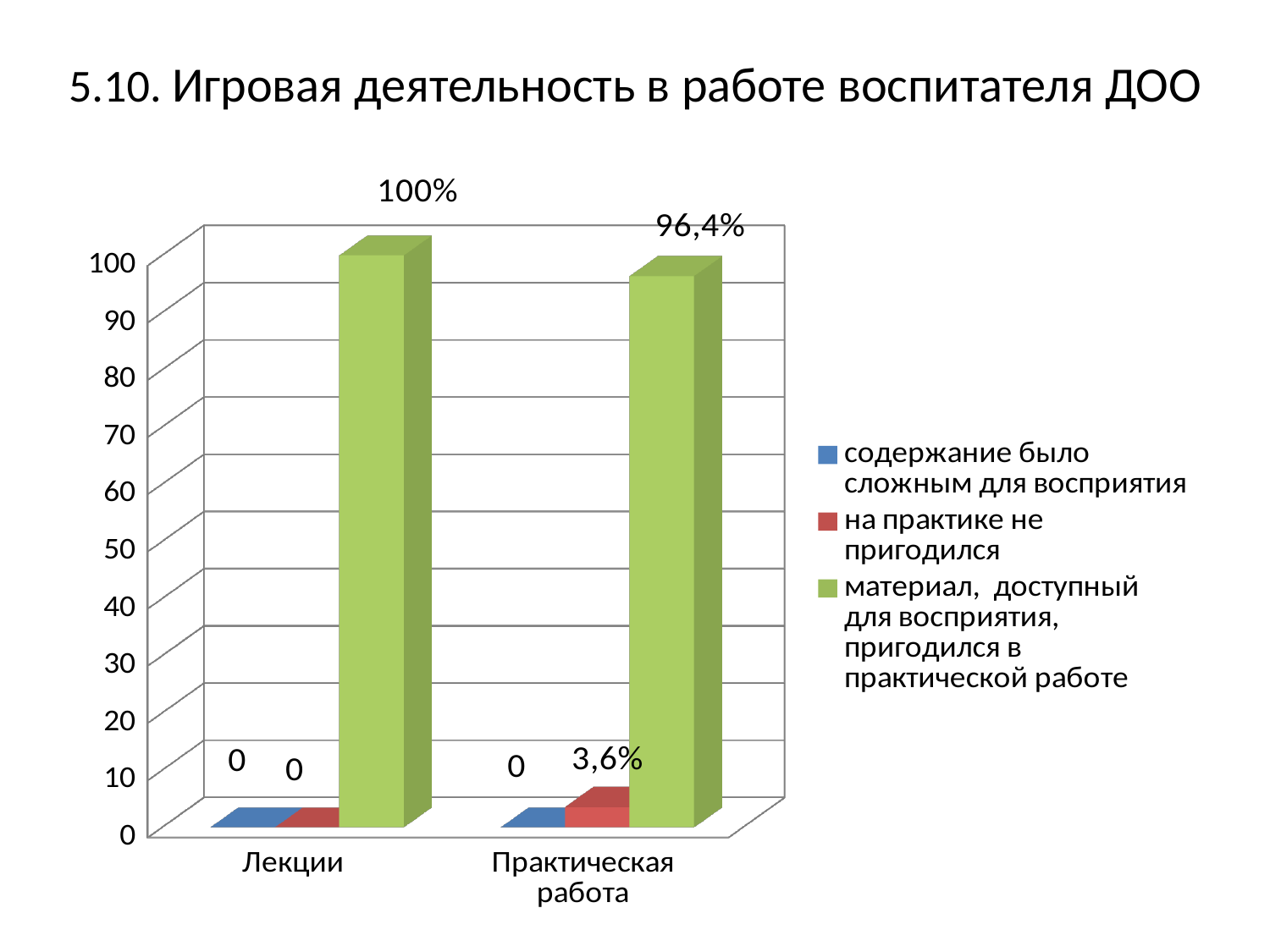
What is the value for "на практике не пригодился" for Практическая работа? 3,6% What kind of chart is shown on the slide? bar chart What is the value for "материал, доступный для восприятия, пригодился в практической работе" for Лекции? 100% What is the difference between the "материал, доступный для восприятия, пригодился в практической работе" values for Лекции and Практическая работа? 3,6% What is the value for "на практике не пригодился" for Лекции? 0 How many series does the legend list? 3 Which category has the higher value for "материал, доступный для восприятия, пригодился в практической работе"? Лекции What is the value for "содержание было сложным для восприятия" for Лекции? 0 Is the value for "материал, доступный для восприятия, пригодился в практической работе" for Практическая работа greater or less than 90? greater What is the value for "материал, доступный для восприятия, пригодился в практической работе" for Практическая работа? 96,4% Which series has the lowest value for Практическая работа? содержание было сложным для восприятия How many categories are shown on the x axis? 2